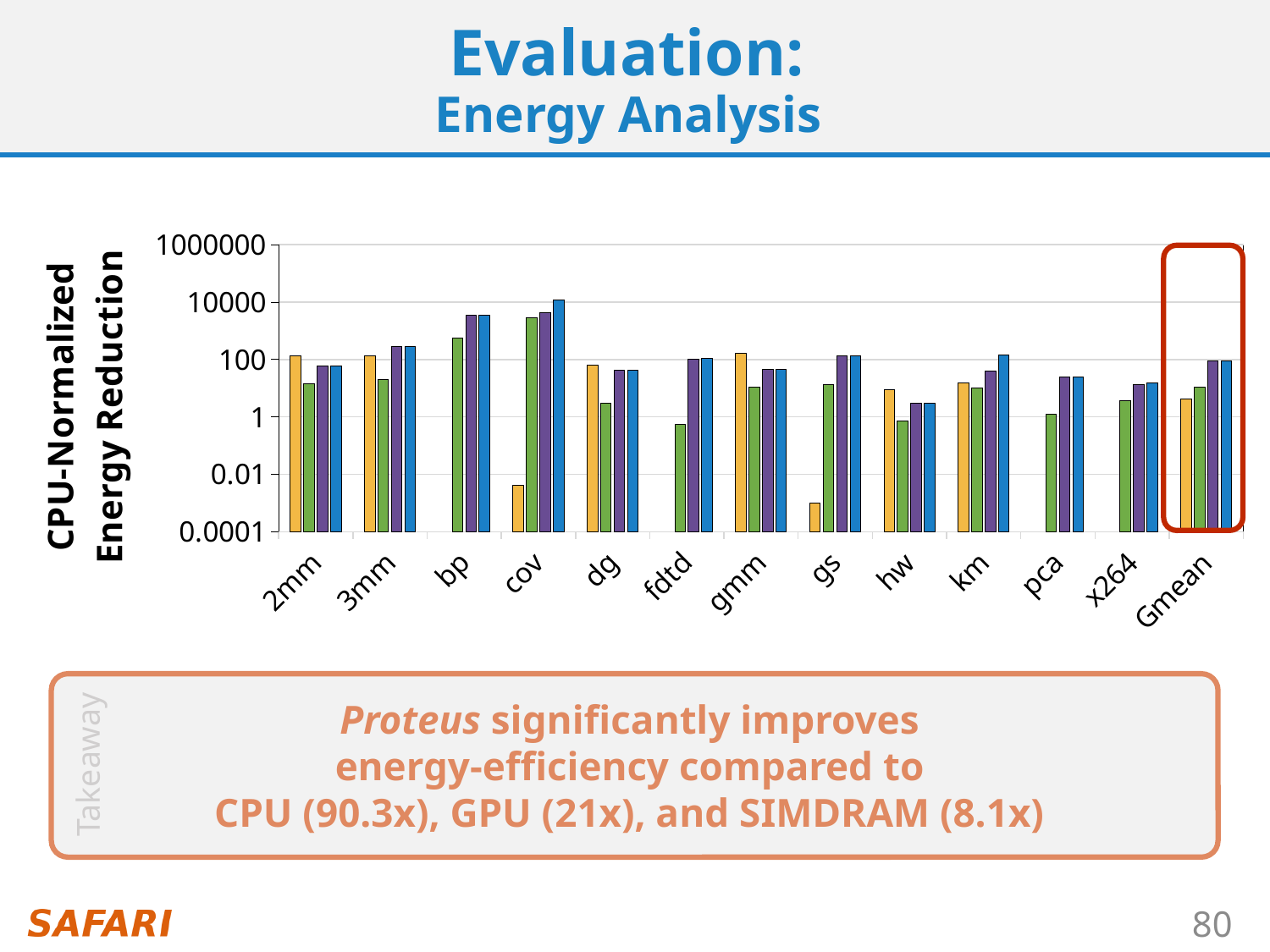
Is the value of the green bar for fdtd greater or less than 1? less Which category has the lowest yellow bar on the chart? gs Which category is highlighted with a red outline on the chart? Gmean How many categories are shown along the x axis of the chart? 13 Is the value of the yellow bar for gs greater or less than 0.01? less Is the value of the yellow bar for hw greater or less than 100? less For cov, which is larger: the yellow bar or the blue bar? the blue bar What kind of chart is shown on the slide? bar chart What is the label of the y axis of the chart? CPU-Normalized Energy Reduction Which category contains the tallest bar on the chart? cov